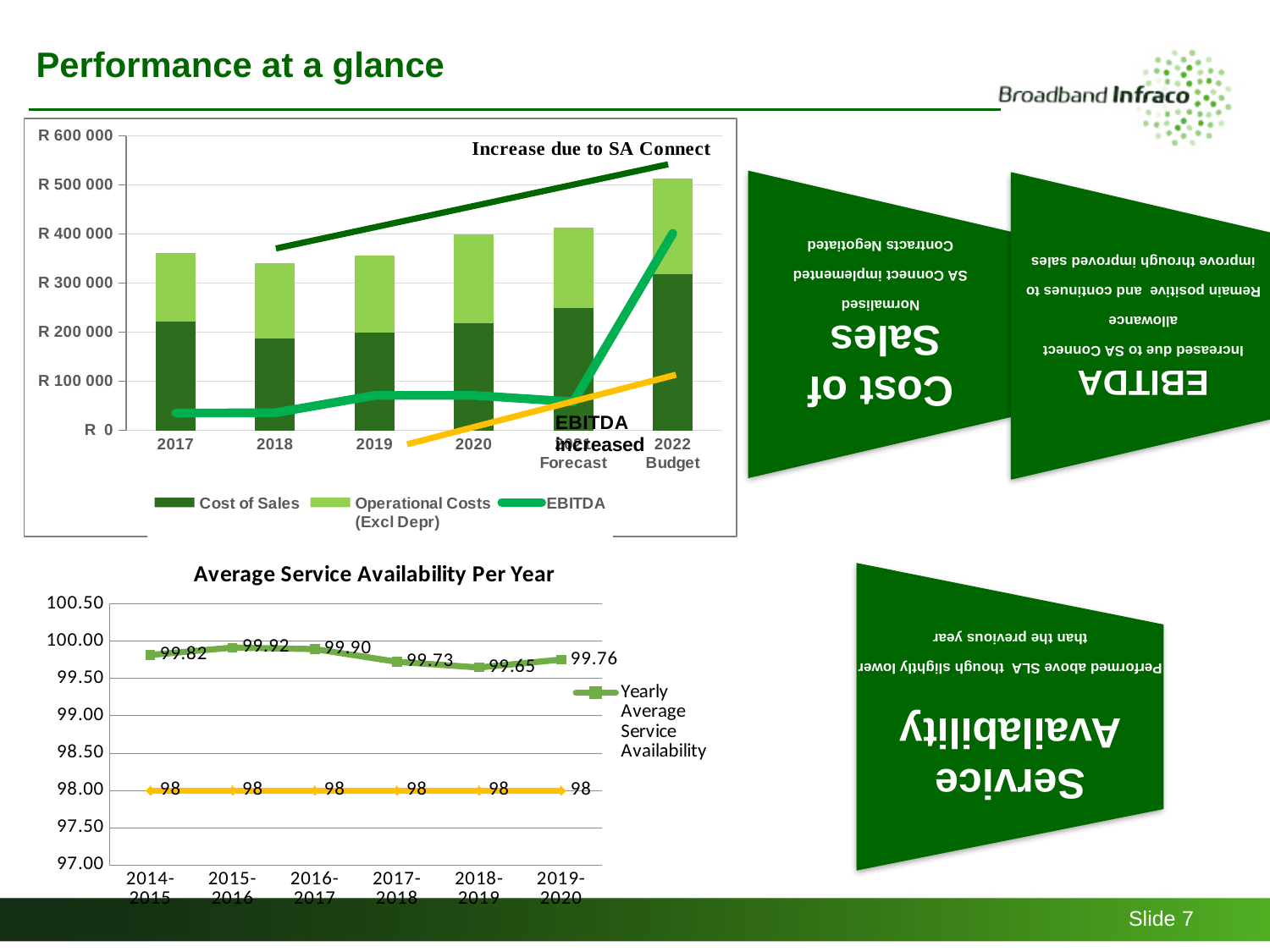
In the Average Service Availability Per Year chart, what is the difference between the Yearly Average Service Availability for 2015-2016 and 2018-2019? 0.27 What kind of chart is the Average Service Availability Per Year chart? Line chart How many series does the legend of the top-left chart list? 3 What kind of chart is the top-left chart showing Cost of Sales and Operational Costs? Combination chart: stacked bar chart with a line (EBITDA) In the Average Service Availability Per Year chart, what is the Yearly Average Service Availability for 2015-2016? 99.92 In the Average Service Availability Per Year chart, which year has the lowest Yearly Average Service Availability? 2018-2019 In the top-left chart, which period has the tallest stacked bar? 2022 Budget In the Average Service Availability Per Year chart, does the Yearly Average Service Availability rise or fall from 2016-2017 to 2018-2019? Fall In the Average Service Availability Per Year chart, what is the Yearly Average Service Availability for 2019-2020? 99.76 In the Average Service Availability Per Year chart, how many years are plotted on the x axis? 6 In the top-left chart, is the Cost of Sales value for 2022 Budget greater or less than R 300 000? greater In the Average Service Availability Per Year chart, which year has the highest Yearly Average Service Availability? 2015-2016